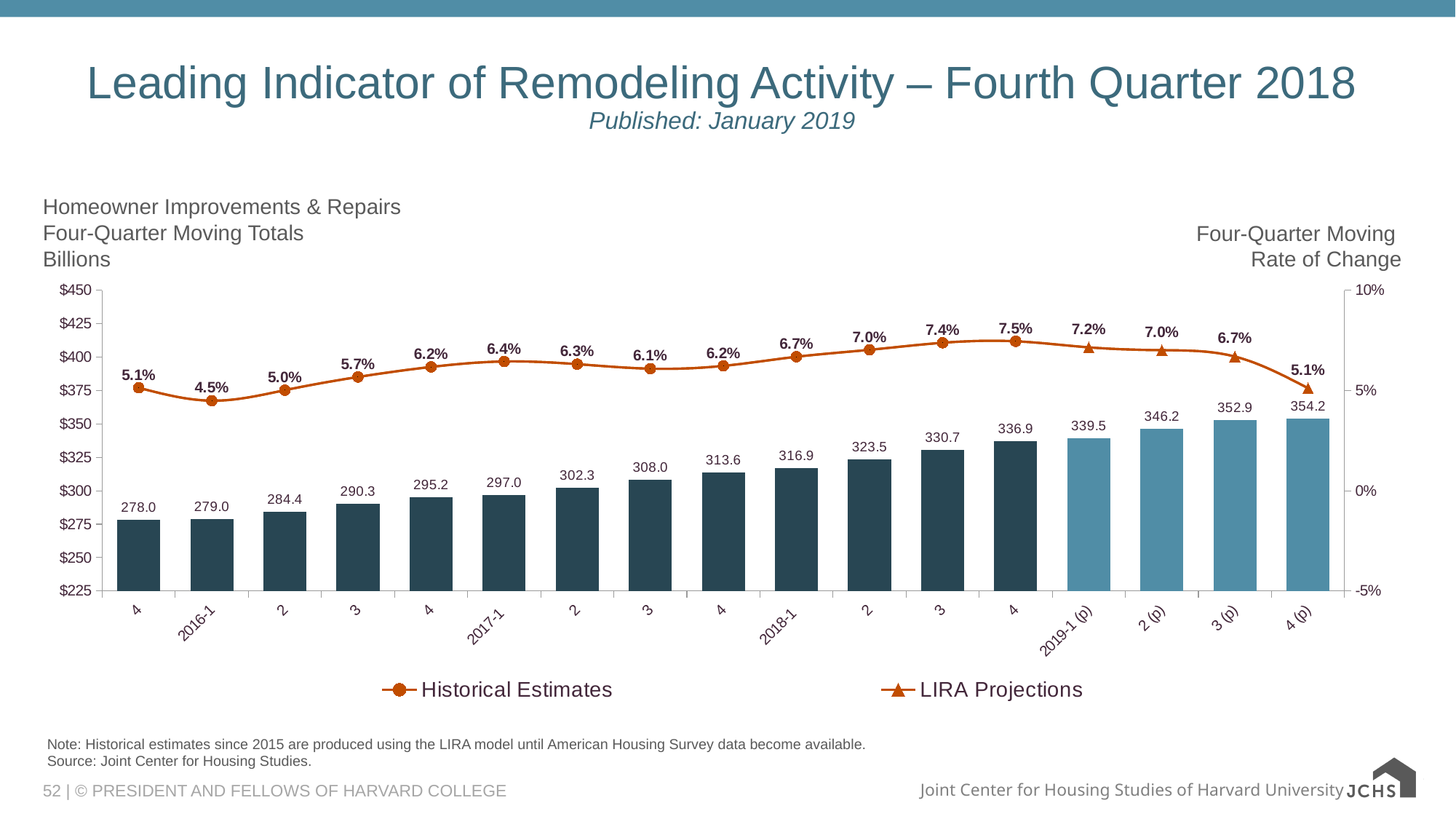
How many series does the legend list? 2 Which has the higher rate of change: quarter 2 of 2017 or quarter 2 of 2018? Quarter 2 of 2018 (7.0%) What four-quarter moving rate of change is labeled for 2017-1? 6.4% What is the four-quarter moving total (in billions) shown for 2018-1? 316.9 How many bars (quarters) are plotted on the chart? 17 Which quarter has the lowest four-quarter moving rate of change on the line? 2016-1 (4.5%) What are the two legend entries on the chart? Historical Estimates and LIRA Projections Which quarter has the highest four-quarter moving rate of change on the line? 2018 quarter 4 (7.5%) What is the difference between the last bar, 4 (p) of 2019, and the first bar, quarter 4 of 2015, in billions? 76.2 Do the four-quarter moving total bars rise or fall from left to right across the chart? Rise What is the projected four-quarter moving total for 3 (p) in 2019? 352.9 What kind of chart is shown on the slide? Combination bar and line chart